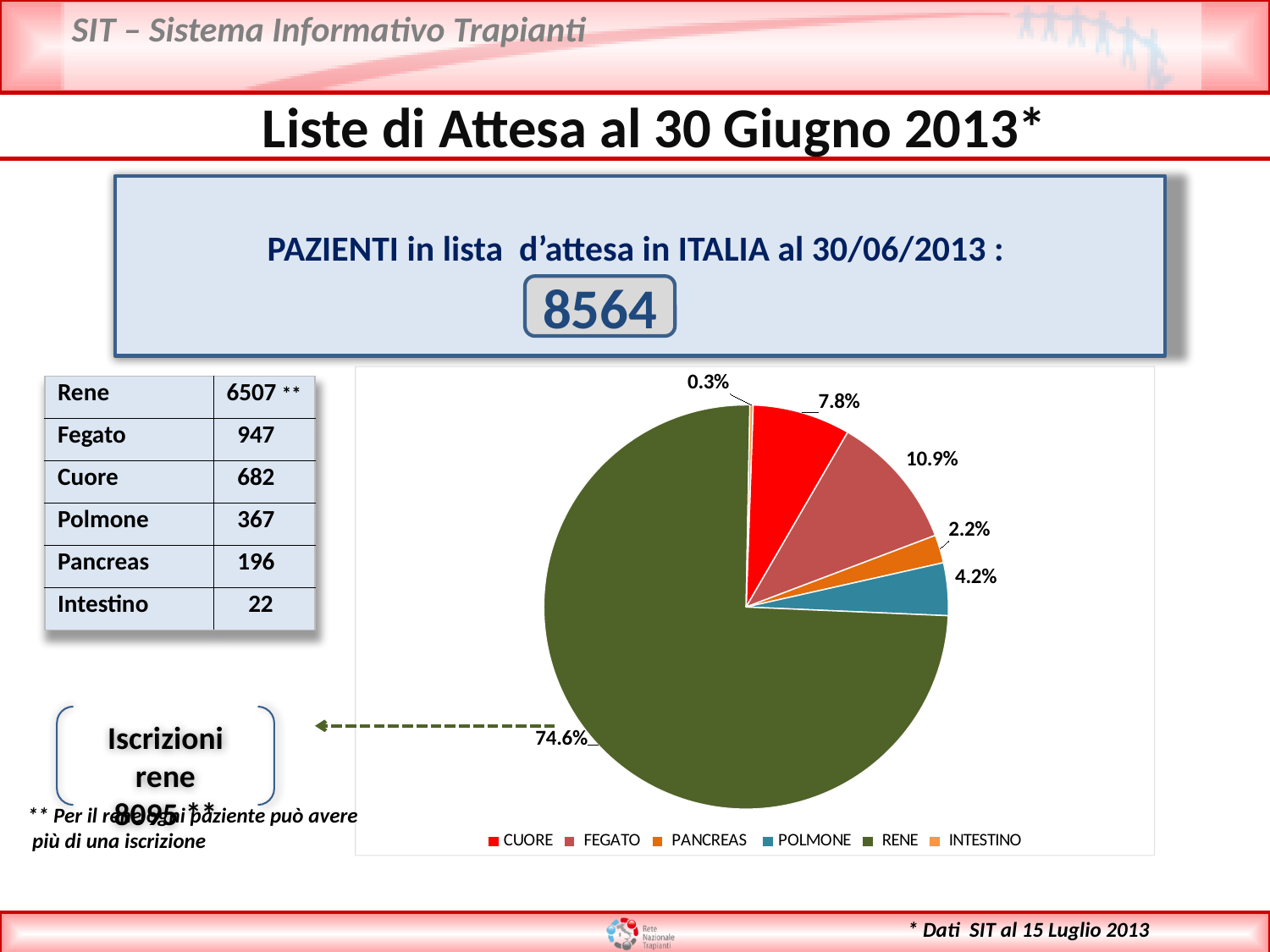
Which category has the largest slice in the pie chart? RENE What percentage is shown for CUORE in the pie chart? 7.8% What kind of chart is shown on the slide? pie chart What percentage is shown for POLMONE in the pie chart? 4.2% What colour is the RENE slice in the pie chart? dark green Which category has the smallest slice in the pie chart? INTESTINO How many categories does the pie chart legend list? 6 What percentage is shown for PANCREAS in the pie chart? 2.2% Which slice is larger in the pie chart, FEGATO or CUORE? FEGATO What percentage is shown for FEGATO in the pie chart? 10.9% What is the difference in percentage points between the FEGATO and POLMONE slices? 6.7 What share of the pie chart does RENE represent? 74.6%